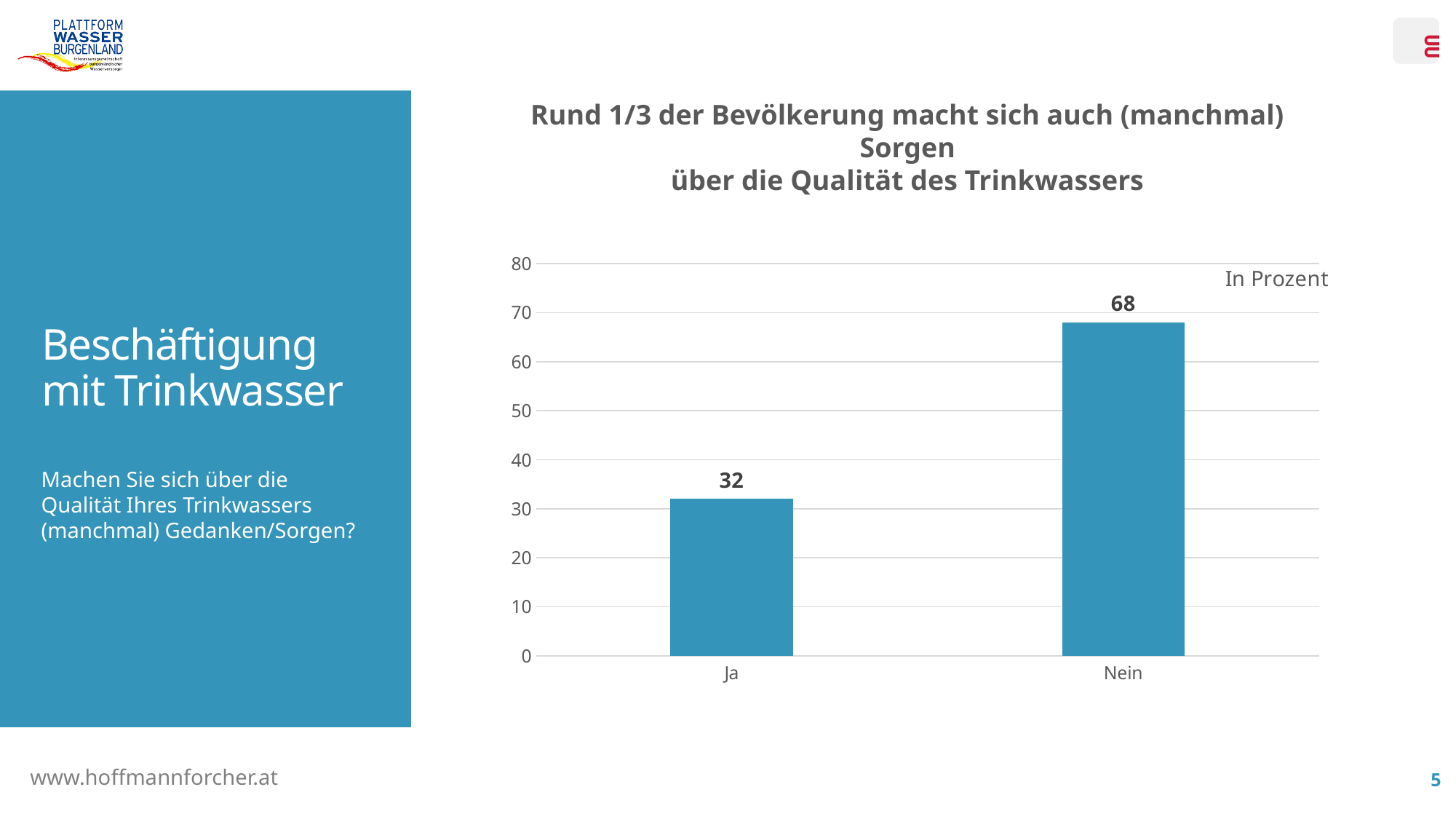
How many categories are shown on the x axis? 2 Is the value for "Ja" greater or less than 40? less What is the difference between the values for "Nein" and "Ja"? 36 What unit label is shown at the top right of the chart? In Prozent Which is larger, the value for "Ja" or the value for "Nein"? Nein What kind of chart is shown on the slide? bar chart What is the value for "Nein"? 68 What is the value for "Ja"? 32 Which category has the lowest value? Ja What is the total of the two bar values? 100 Which category has the highest value? Nein Is the value for "Nein" greater or less than 60? greater